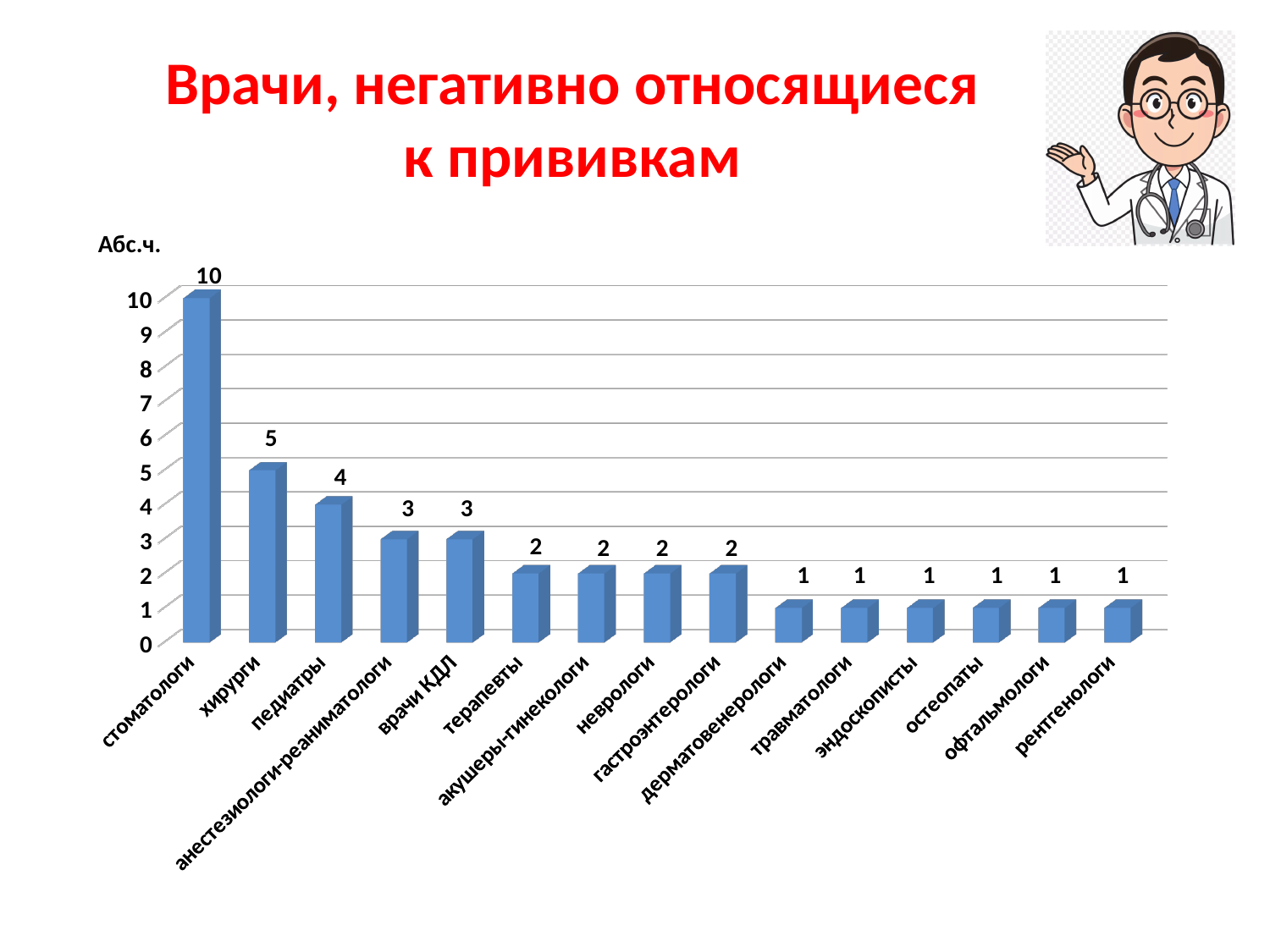
Which category has the highest value? стоматологи What is the difference between the values for стоматологи and хирурги? 5 What is the value for стоматологи? 10 What is the value for хирурги? 5 How many categories are shown on the x axis? 15 What is the value for врачи КДЛ? 3 Which is larger, the value for педиатры or the value for терапевты? педиатры What is the value for неврологи? 2 What is the value for рентгенологи? 1 What is the label on the vertical axis? Абс.ч. What is the value for педиатры? 4 What kind of chart is shown on the slide? bar chart